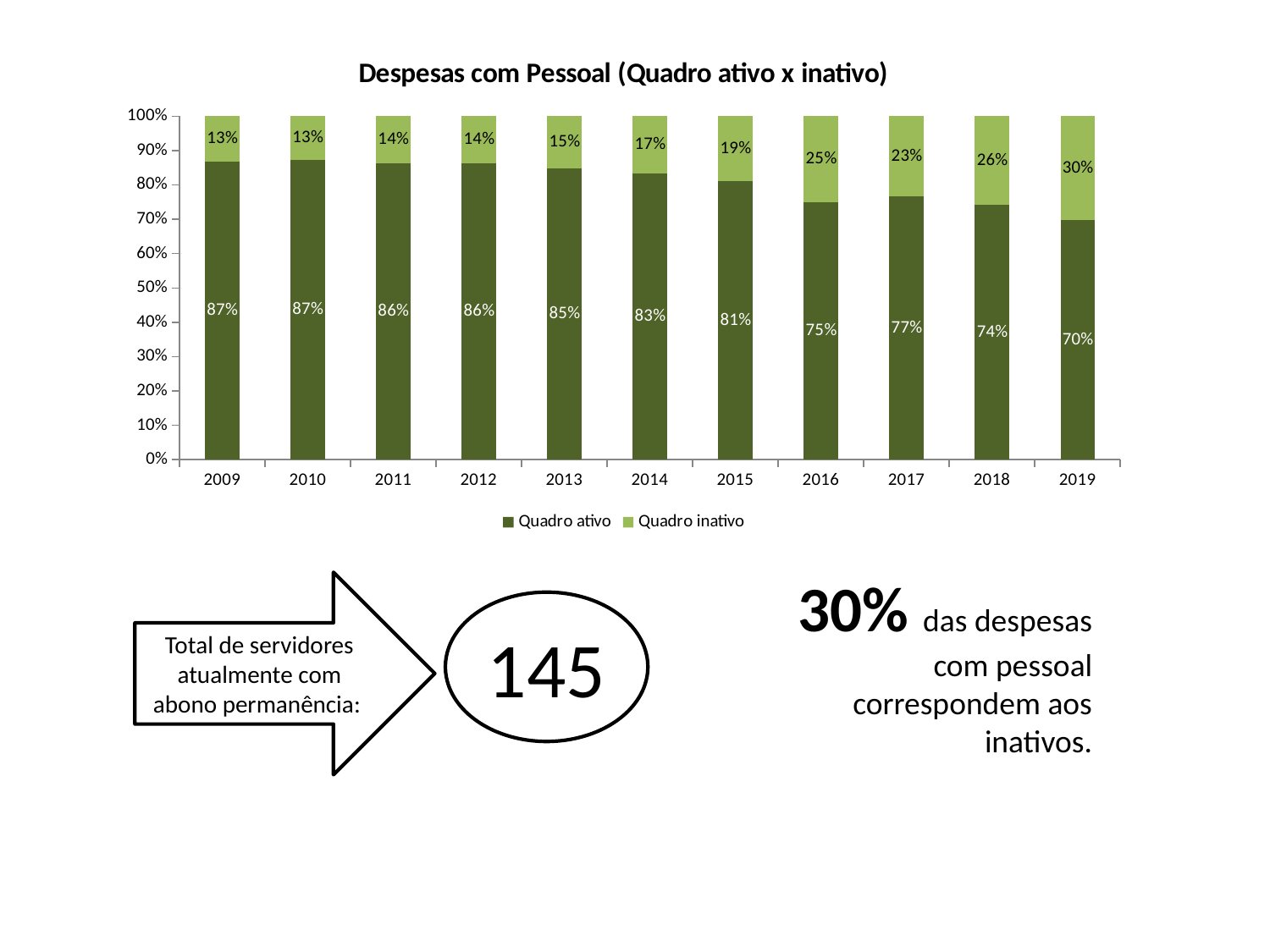
What is the value for Quadro ativo in 2017? 77% How many years are shown on the x axis? 11 What is the value for Quadro inativo in 2019? 30% In which year is the Quadro ativo share lowest? 2019 In which year is the Quadro inativo share highest? 2019 How many series does the legend list? 2 What is the difference between the Quadro ativo values for 2009 and 2019? 17% Which is larger, the Quadro inativo value for 2016 or for 2017? 2016 What is the value for Quadro inativo in 2016? 25% What is the value for Quadro ativo in 2009? 87% What kind of chart is shown? Stacked bar chart Does the Quadro inativo share generally rise or fall from 2009 to 2019? Rise